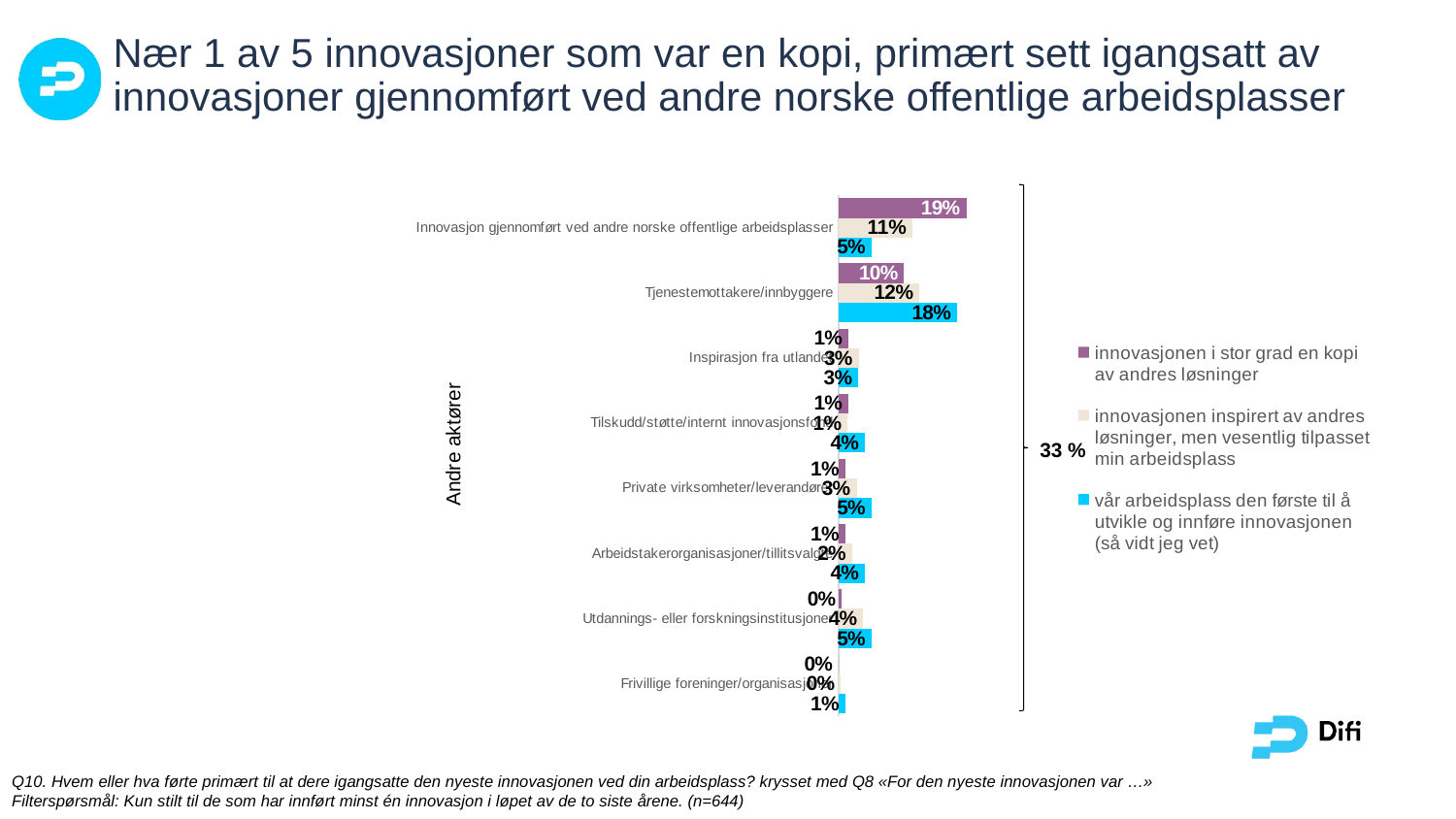
Which category has the highest value in the series 'innovasjonen i stor grad en kopi av andres løsninger'? Innovasjon gjennomført ved andre norske offentlige arbeidsplasser What is the value for 'Utdannings- eller forskningsinstitusjoner' in the series 'innovasjonen i stor grad en kopi av andres løsninger'? 0% How many categories are shown on the chart? 8 What is the axis label shown on the left side of the chart? Andre aktører What is the value for 'Tjenestemottakere/innbyggere' in the series 'innovasjonen inspirert av andres løsninger, men vesentlig tilpasset min arbeidsplass'? 12% For 'Tjenestemottakere/innbyggere', which is larger: the 'innovasjonen i stor grad en kopi av andres løsninger' value or the 'vår arbeidsplass den første til å utvikle og innføre innovasjonen (så vidt jeg vet)' value? vår arbeidsplass den første til å utvikle og innføre innovasjonen (så vidt jeg vet) Which category has the highest value in the series 'vår arbeidsplass den første til å utvikle og innføre innovasjonen (så vidt jeg vet)'? Tjenestemottakere/innbyggere What kind of chart is shown on the slide? Bar chart What is the difference between the 'innovasjonen i stor grad en kopi av andres løsninger' value and the 'vår arbeidsplass den første til å utvikle og innføre innovasjonen (så vidt jeg vet)' value for 'Innovasjon gjennomført ved andre norske offentlige arbeidsplasser'? 14 percentage points What is the value for 'Tjenestemottakere/innbyggere' in the series 'vår arbeidsplass den første til å utvikle og innføre innovasjonen (så vidt jeg vet)'? 18% What is the value for 'Innovasjon gjennomført ved andre norske offentlige arbeidsplasser' in the series 'innovasjonen i stor grad en kopi av andres løsninger'? 19% How many series does the legend list? 3